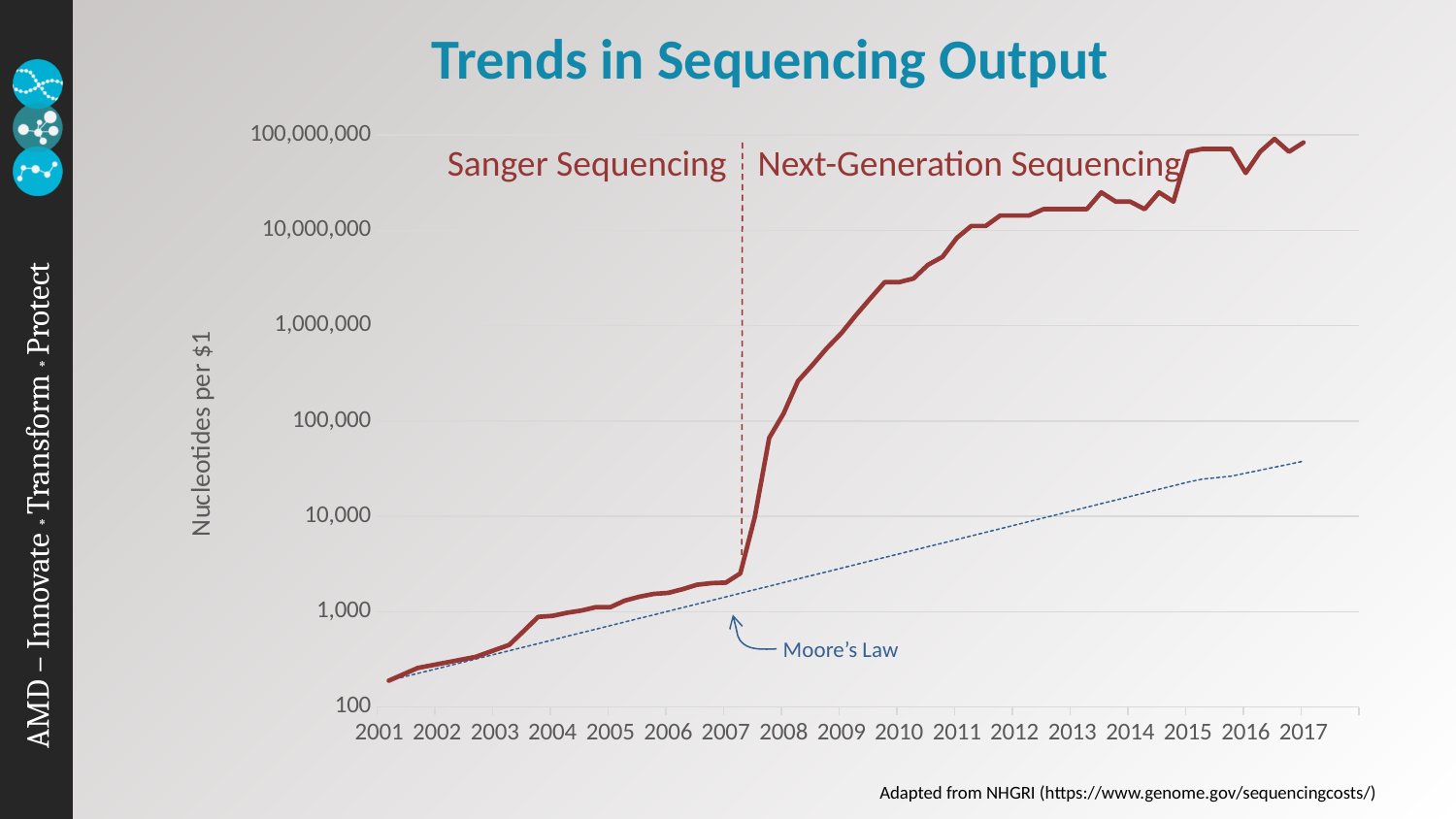
Is the value for 2005 greater or less than 10,000? less What kind of chart is shown on the slide? line chart Does the sequencing output line generally rise or fall from 2001 to 2017? rise Which year has the lowest value on the sequencing output line? 2001 How many years are labelled on the x axis? 17 What is the label on the y axis of the chart? Nucleotides per $1 Is the Moore's Law line at 2017 greater or less than 100,000? less What is the title of the chart? Trends in Sequencing Output Which is larger, the value for 2001 or the value for 2017? 2017 Is the value for 2010 greater or less than 1,000,000? greater